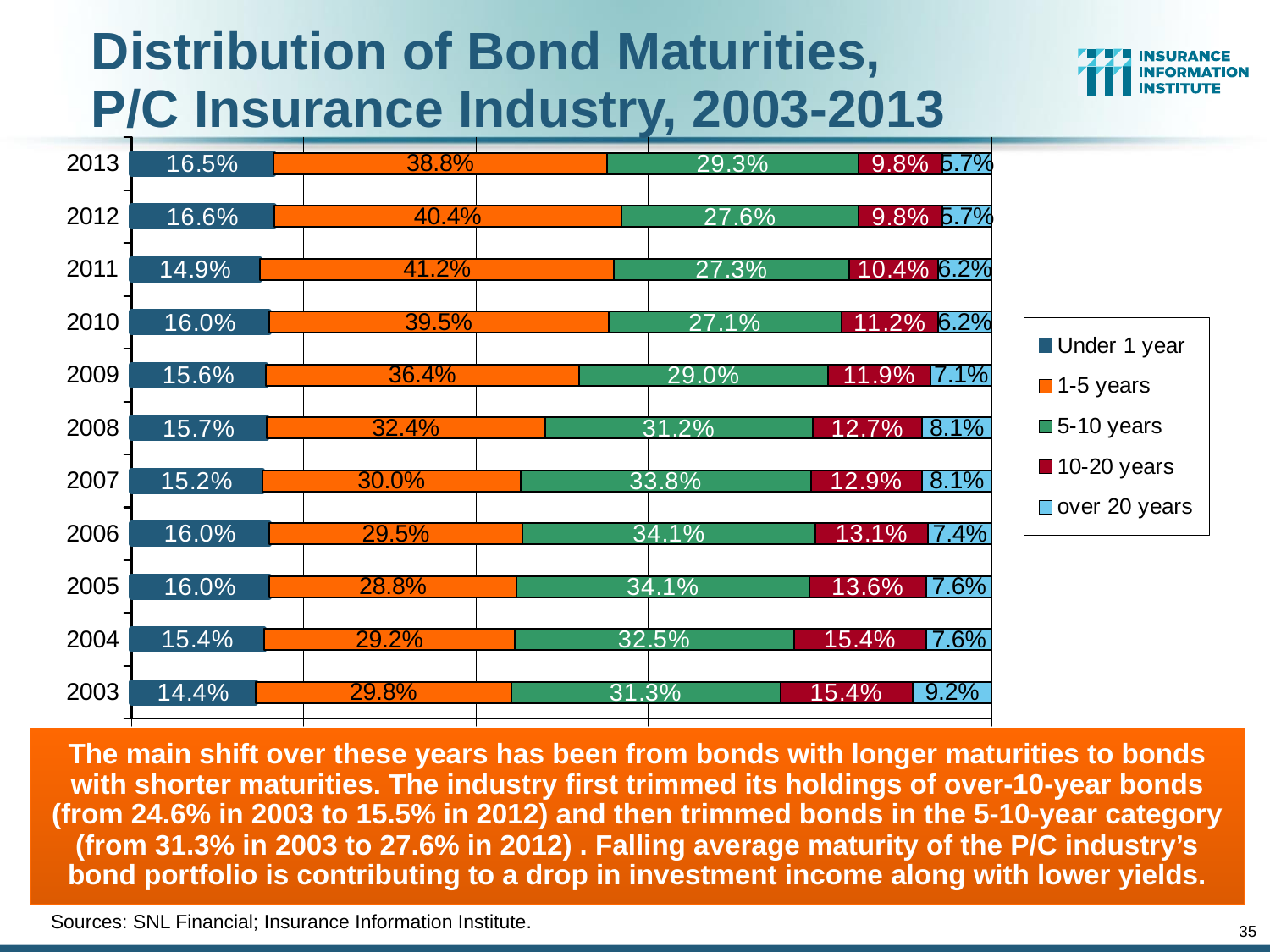
Did the share of 1-5 year bonds generally rise or fall from 2003 to 2013? Rise What colour represents the 1-5 years category in the legend? Orange What share of bonds had maturities of 1-5 years in 2011? 41.2% What share of bonds had maturities of 5-10 years in 2006? 34.1% Which year had the highest share of 1-5 year bonds? 2011 Which year had the highest share of over 20 years bonds? 2003 In 2007, which was larger: the 1-5 years share or the 5-10 years share? 5-10 years What kind of chart is shown on the slide? Stacked bar chart What was the Under 1 year share in 2003? 14.4% By how many percentage points did the 10-20 years share fall from 2003 to 2013? 5.6 percentage points How many years are shown on the chart? 11 How many series does the legend list? 5